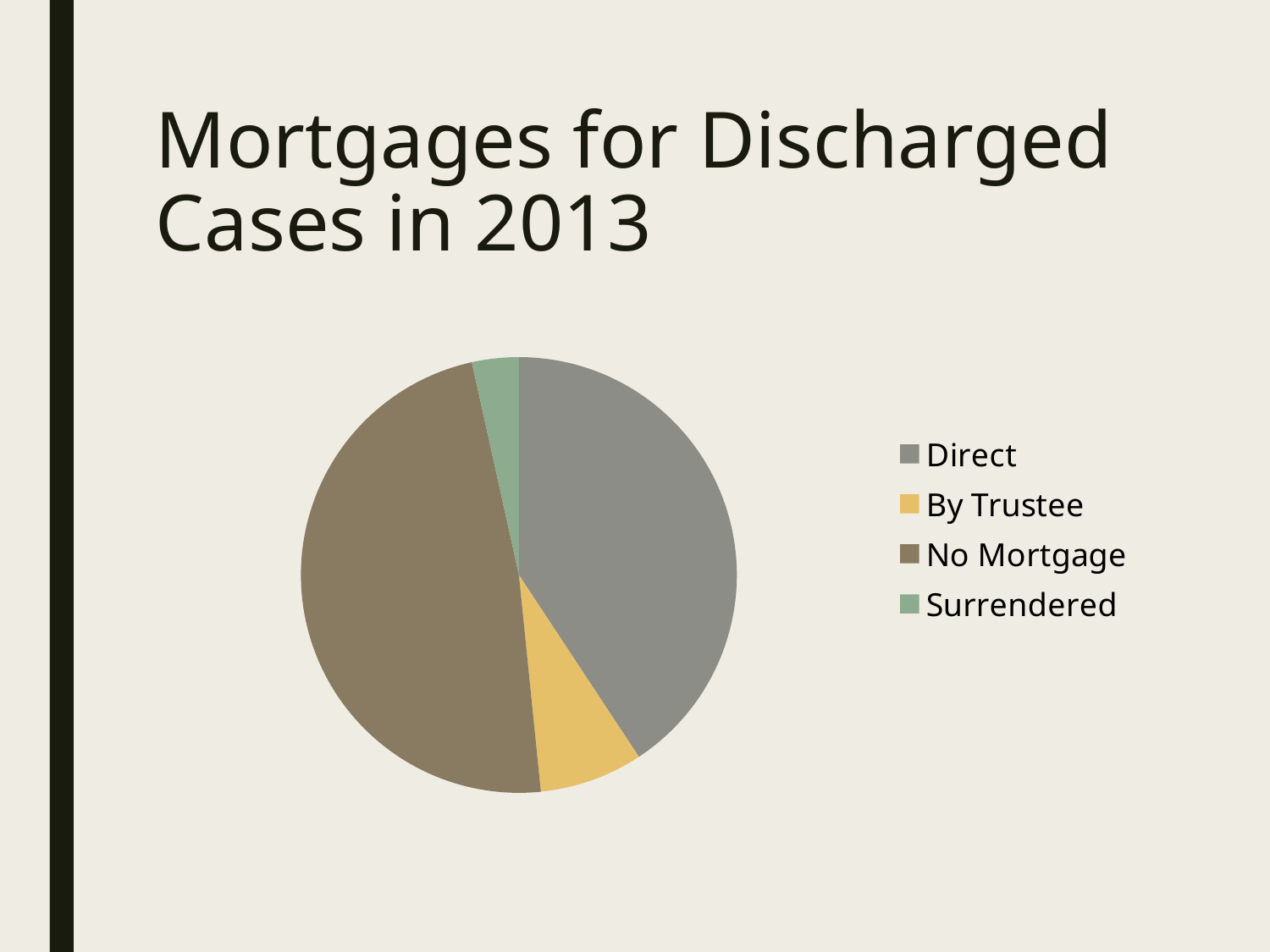
Which slice is larger, Direct or By Trustee? Direct Which category has the smallest slice of the pie? Surrendered Which category is shown in yellow in the pie chart? By Trustee How many slices does the pie chart have? 4 Which category has the largest slice of the pie? No Mortgage How many entries does the legend list? 4 What kind of chart is shown on the slide? pie chart Which slice is larger, No Mortgage or Surrendered? No Mortgage Which slice is larger, By Trustee or Surrendered? By Trustee What is the title of the slide containing the pie chart? Mortgages for Discharged Cases in 2013